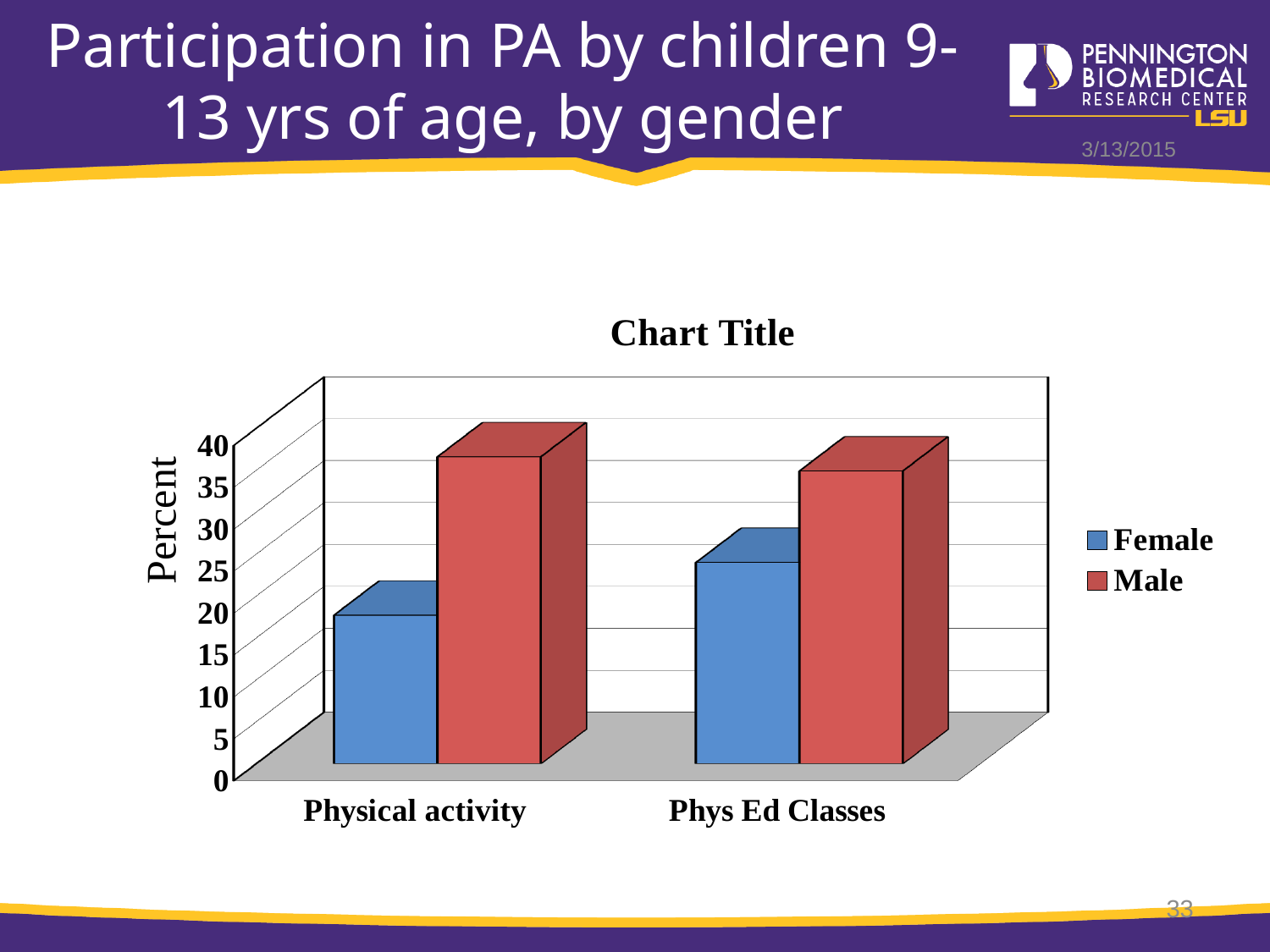
What kind of chart is shown on the slide? bar chart Which series has the lowest bar in the chart? Female, Physical activity For Phys Ed Classes, which is larger, the Female value or the Male value? Male What is the label on the vertical axis of the chart? Percent How many series does the legend list? 2 For Physical activity, which is larger, the Female value or the Male value? Male Is the Female value for Physical activity greater or less than 30? less Which bar is the highest in the chart? Male, Physical activity Is the Female value for Phys Ed Classes greater or less than 35? less How many categories are shown on the x axis? 2 Is the Male value for Physical activity greater or less than 30? greater